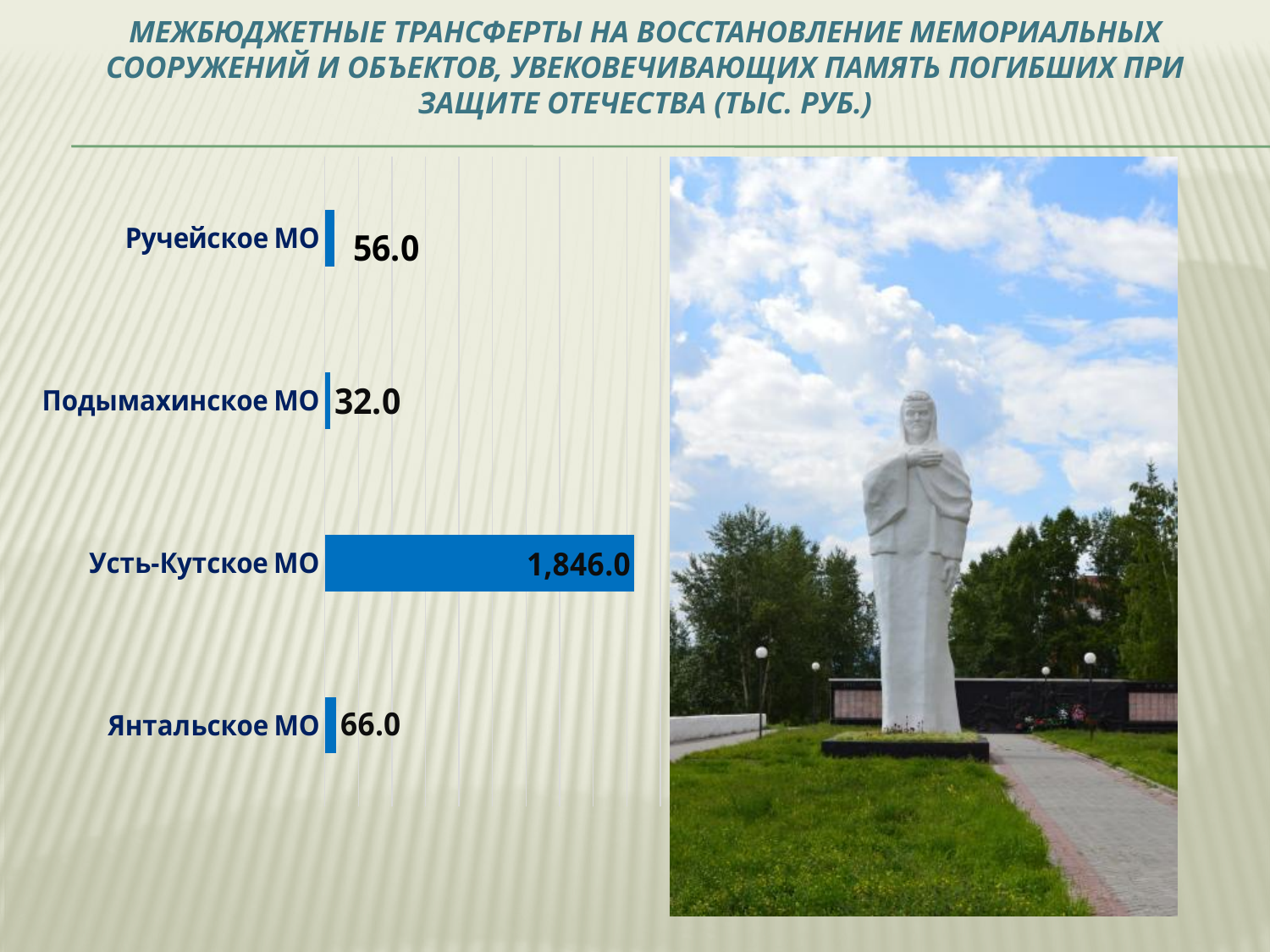
In what units are the values in the chart expressed, according to the slide title? тыс. руб. What is the value for Подымахинское МО? 32.0 Which category has the lowest value? Подымахинское МО How many categories are shown in the chart? 4 What is the value for Янтальское МО? 66.0 What is the difference between the values for Усть-Кутское МО and Янтальское МО? 1,780.0 What is the value for Усть-Кутское МО? 1,846.0 What kind of chart is shown on the slide? Bar chart Which is larger, the value for Янтальское МО or the value for Ручейское МО? Янтальское МО What is the value for Ручейское МО? 56.0 What is the difference between the values for Ручейское МО and Подымахинское МО? 24.0 Which category has the highest value? Усть-Кутское МО